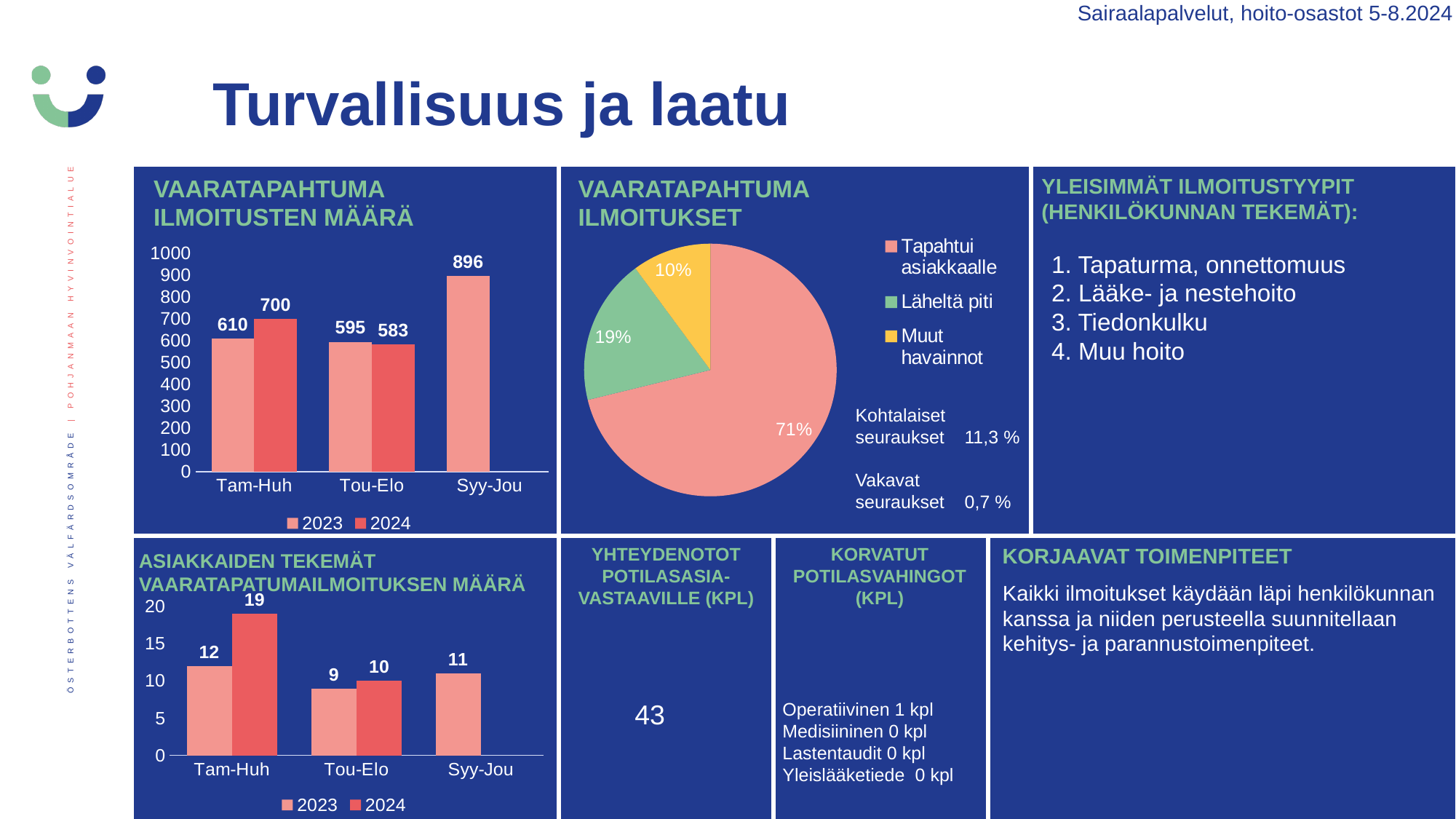
In the 'VAARATAPAHTUMA ILMOITUSTEN MÄÄRÄ' chart, what is the 2023 value for Syy-Jou? 896 In the 'ASIAKKAIDEN TEKEMÄT VAARATAPATUMAILMOITUKSEN MÄÄRÄ' chart, how many categories are shown on the x axis? 3 What kind of chart is 'VAARATAPAHTUMA ILMOITUKSET'? Pie chart In the 'VAARATAPAHTUMA ILMOITUSTEN MÄÄRÄ' chart, what is the difference between the 2023 and 2024 values for Tou-Elo? 12 In the 'ASIAKKAIDEN TEKEMÄT VAARATAPATUMAILMOITUKSEN MÄÄRÄ' chart, what is the 2024 value for Tam-Huh? 19 In the 'VAARATAPAHTUMA ILMOITUKSET' pie chart, what share does 'Läheltä piti' have? 19% In the 'VAARATAPAHTUMA ILMOITUKSET' pie chart, which slice is the smallest? Muut havainnot In the 'VAARATAPAHTUMA ILMOITUSTEN MÄÄRÄ' chart, which category has the highest 2023 value? Syy-Jou In the 'VAARATAPAHTUMA ILMOITUSTEN MÄÄRÄ' chart, how many series does the legend list? 2 In the 'ASIAKKAIDEN TEKEMÄT VAARATAPATUMAILMOITUKSEN MÄÄRÄ' chart, which is larger for Tou-Elo, the 2023 or the 2024 value? 2024 In the 'VAARATAPAHTUMA ILMOITUSTEN MÄÄRÄ' chart, what is the 2024 value for Tam-Huh? 700 In the 'VAARATAPAHTUMA ILMOITUKSET' pie chart, which slice is the largest? Tapahtui asiakkaalle